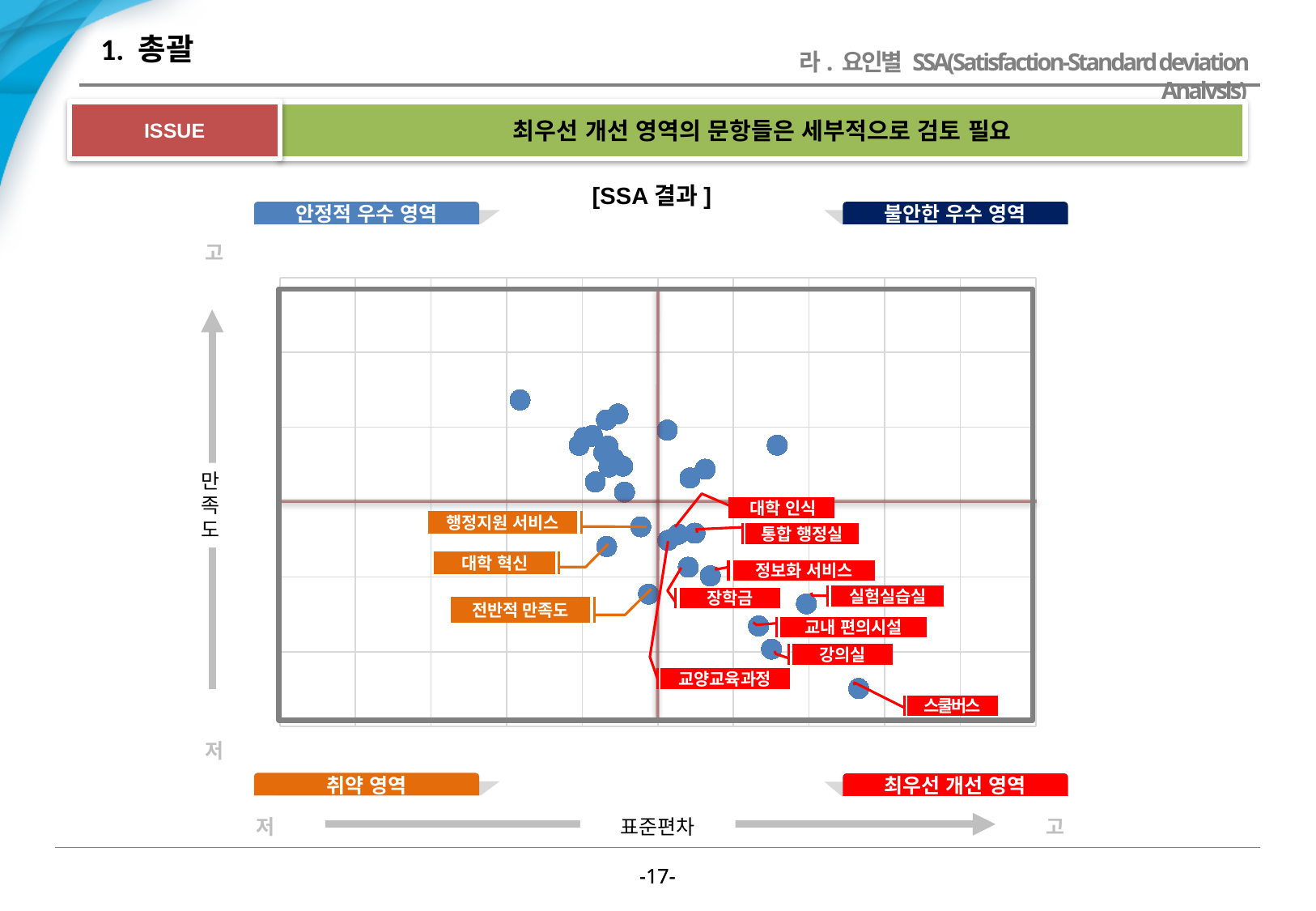
What kind of chart is shown on the slide? scatter chart Which labeled point has the lowest 만족도 (satisfaction)? 스쿨버스 Which has the higher 만족도, 스쿨버스 or 행정지원 서비스? 행정지원 서비스 How many data points on the chart have a text label attached? 12 What is the label of the horizontal axis of the chart? 표준편차 Which has the larger 표준편차, 실험실습실 or 장학금? 실험실습실 How many points are marked with red labels? 9 Which has the higher 만족도, 강의실 or 교내 편의시설? 교내 편의시설 Which labeled point has the highest 표준편차 (standard deviation)? 스쿨버스 What is the title of the chart? [SSA 결과 ] How many points are marked with orange labels? 3